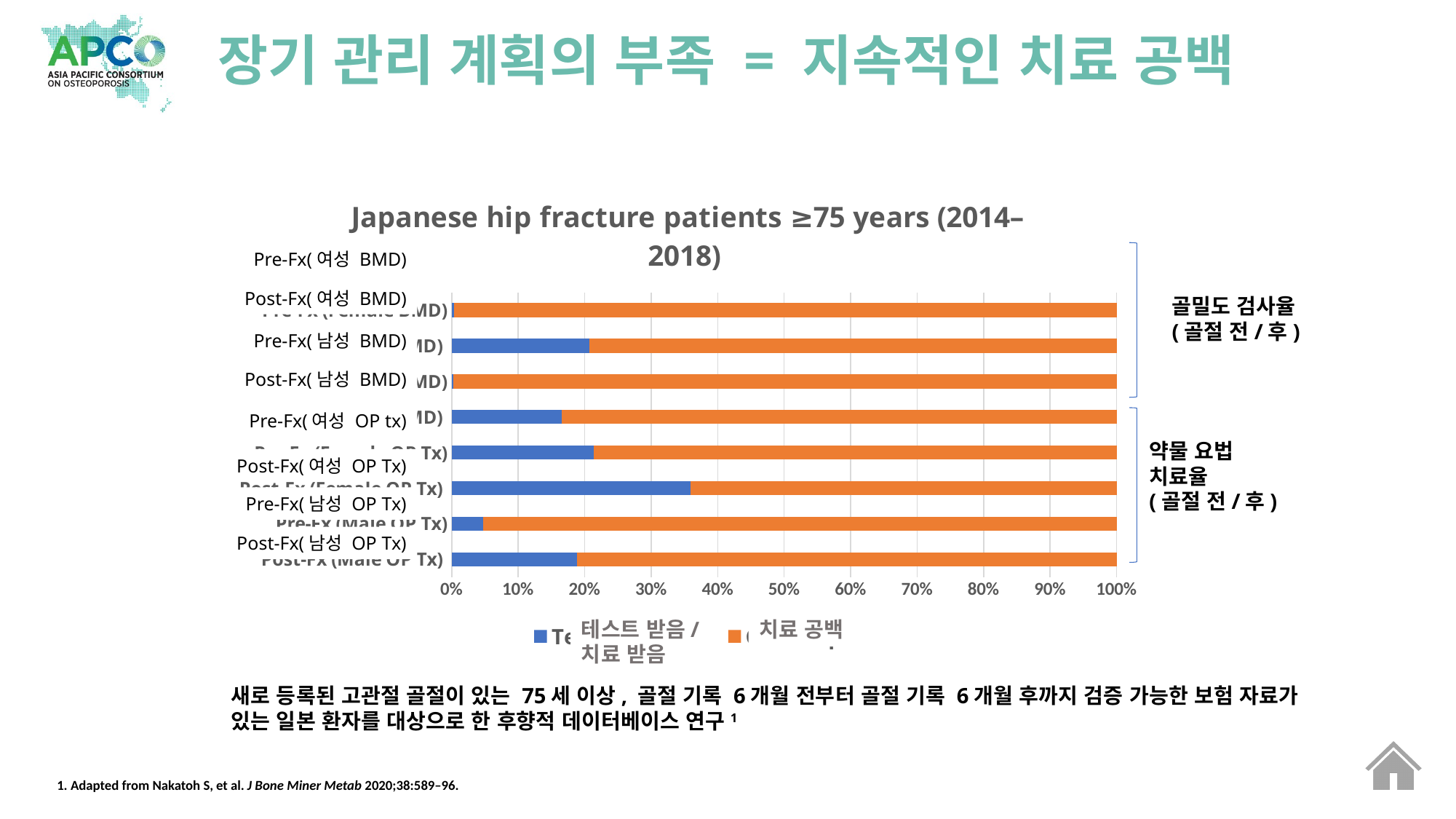
What is the total of each stacked bar in the chart? 100% Is the blue (테스트 받음 / 치료 받음) value for Pre-Fx(여성 BMD) greater or less than 10%? less What is the title of the chart? Japanese hip fracture patients ≥75 years (2014–2018) How many series does the chart's legend list? 2 What colour represents the 치료 공백 (treatment gap) series in the chart? Orange Which has a larger blue (테스트 받음 / 치료 받음) segment, Pre-Fx(남성 OP Tx) or Post-Fx(남성 OP Tx)? Post-Fx(남성 OP Tx) Which category has the largest blue (테스트 받음 / 치료 받음) segment? Post-Fx(여성 OP Tx) Is the blue (테스트 받음 / 치료 받음) value for Pre-Fx(남성 OP Tx) greater or less than 10%? less How many categories (bars) does the chart show? 8 What kind of chart is shown on the slide? Stacked bar chart Is the blue (테스트 받음 / 치료 받음) value for Post-Fx(여성 OP Tx) greater or less than 30%? greater Which has a larger blue (테스트 받음 / 치료 받음) segment, Post-Fx(여성 OP Tx) or Post-Fx(남성 OP Tx)? Post-Fx(여성 OP Tx)